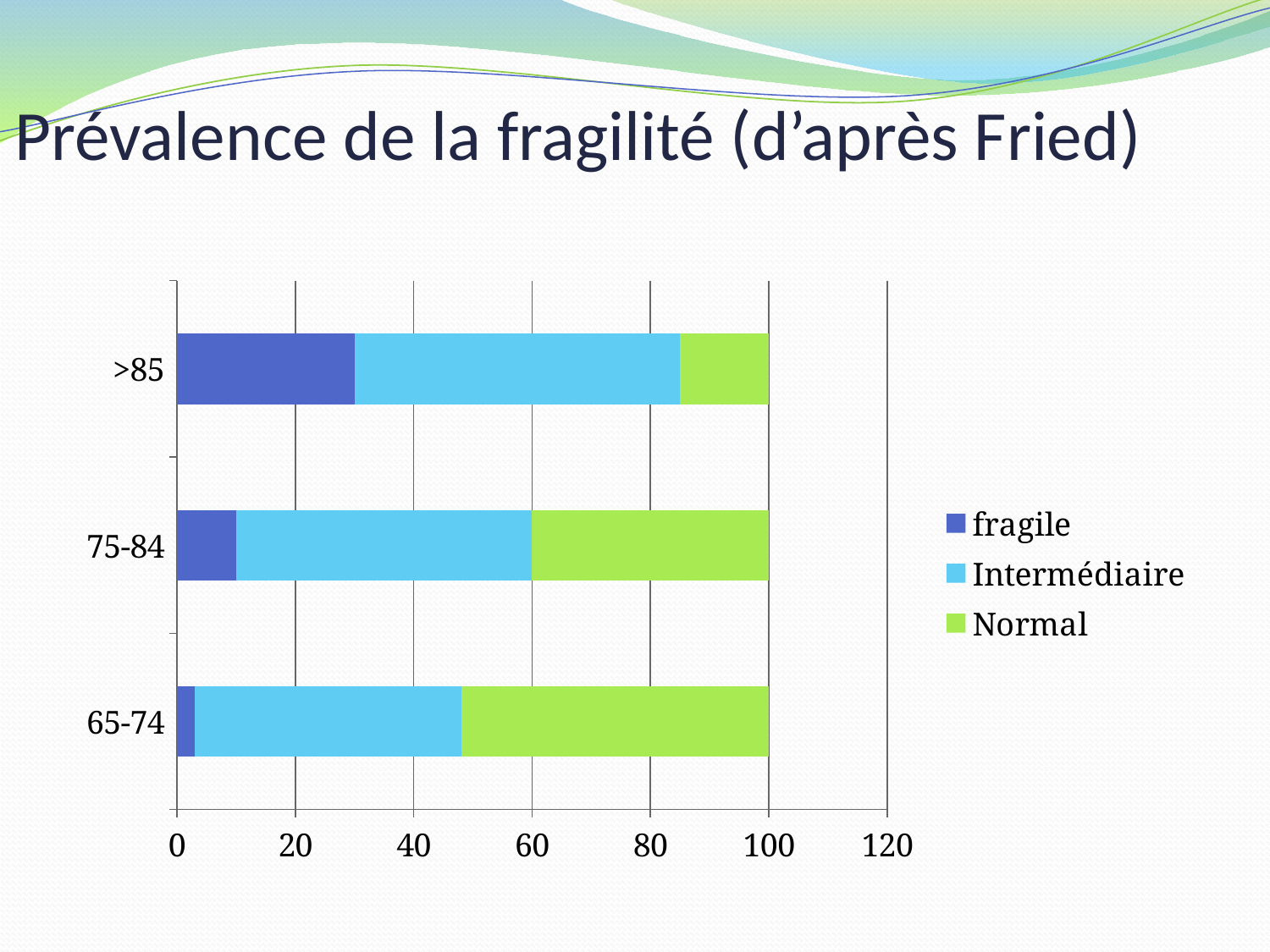
Is the fragile value for the >85 age group greater or less than 20? greater Which age group has a larger Normal segment, >85 or 75-84? 75-84 Which age group has the smallest fragile segment? 65-74 Which series is shown in green in the legend? Normal What is the total of the stacked bar for the >85 age group? 100 What kind of chart is shown on the slide? bar chart How many age groups are shown on the chart? 3 Which age group has the largest fragile segment? >85 Is the fragile value for the 75-84 age group greater or less than 20? less Which age group has the largest Normal segment? 65-74 How many series does the legend list? 3 What is the title of the slide containing the chart? Prévalence de la fragilité (d'après Fried)